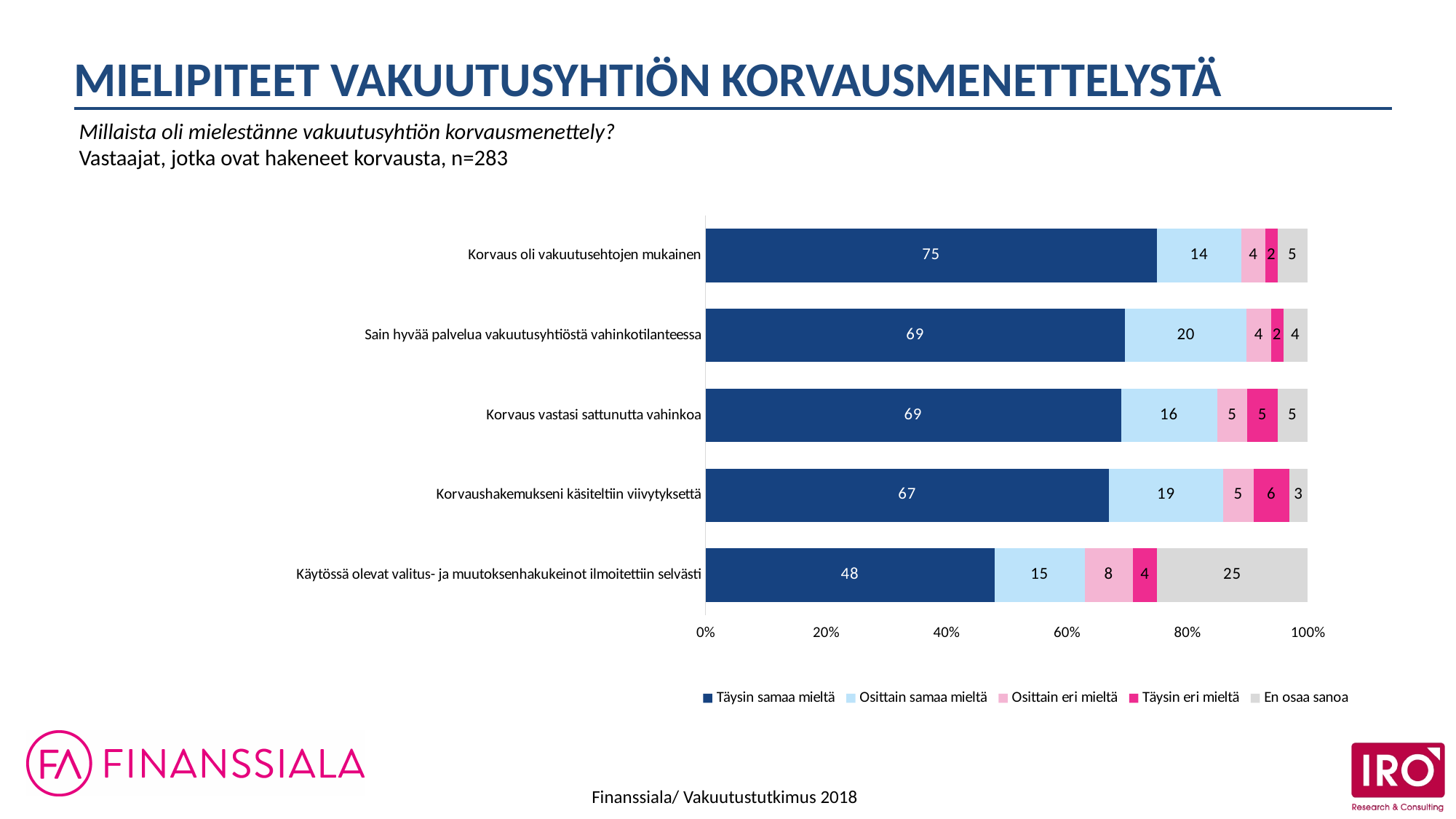
Which statement has the highest 'Täysin samaa mieltä' value? Korvaus oli vakuutusehtojen mukainen How many series does the legend list? 5 What is the 'Osittain samaa mieltä' value for 'Sain hyvää palvelua vakuutusyhtiöstä vahinkotilanteessa'? 20 What is the 'En osaa sanoa' value for 'Käytössä olevat valitus- ja muutoksenhakukeinot ilmoitettiin selvästi'? 25 Which statement has the lowest 'Täysin samaa mieltä' value? Käytössä olevat valitus- ja muutoksenhakukeinot ilmoitettiin selvästi What is the difference between the 'Täysin samaa mieltä' values for 'Korvaus oli vakuutusehtojen mukainen' and 'Käytössä olevat valitus- ja muutoksenhakukeinot ilmoitettiin selvästi'? 27 What kind of chart is shown on the slide? Stacked bar chart What is the 'Täysin eri mieltä' value for 'Korvaushakemukseni käsiteltiin viivytyksettä'? 6 What is the 'Täysin samaa mieltä' value for 'Korvaus oli vakuutusehtojen mukainen'? 75 What is the total of the stacked bar for 'Korvaus vastasi sattunutta vahinkoa'? 100 How many statements (bars) are shown in the chart? 5 Which is larger: the 'Osittain samaa mieltä' value for 'Korvaushakemukseni käsiteltiin viivytyksettä' or for 'Korvaus vastasi sattunutta vahinkoa'? Korvaushakemukseni käsiteltiin viivytyksettä